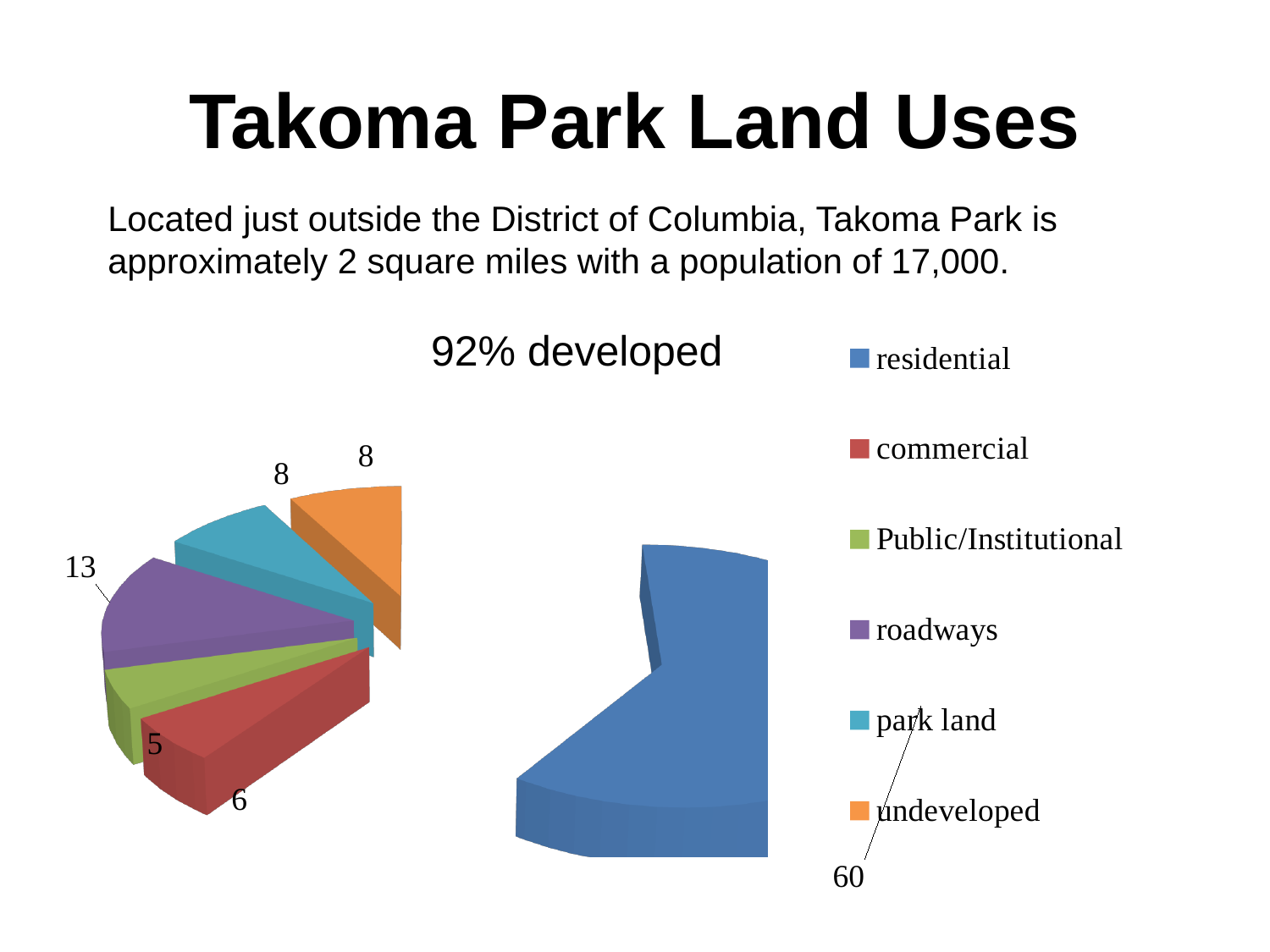
Which is larger, the value for roadways or the value for park land? roadways How many categories does the pie chart show? 6 What is the value for roadways? 13 Which category has the smallest slice of the pie? Public/Institutional What is the difference between the values for residential and roadways? 47 What type of chart is shown on the slide? pie chart What is the value for Public/Institutional? 5 What share of the pie does residential represent? 60% What is the value for commercial? 6 Which category has the largest slice of the pie? residential What is the value for residential? 60